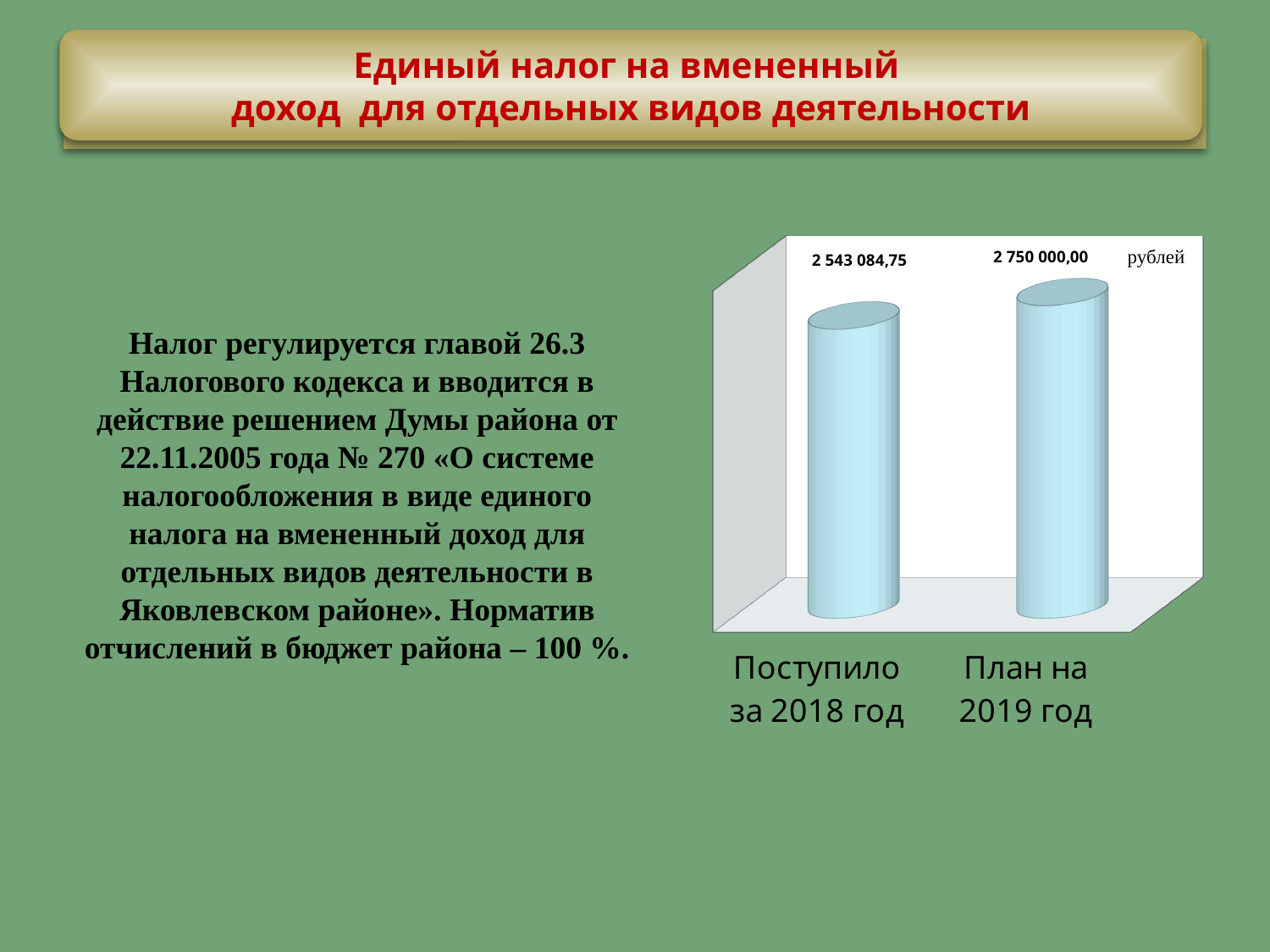
How many categories are plotted in the chart? 2 Which category has the highest value? План на 2019 год Which is larger: the value for "Поступило за 2018 год" or the value for "План на 2019 год"? План на 2019 год What colour are the bars in the chart? light blue What is the difference between the value for "План на 2019 год" and the value for "Поступило за 2018 год"? 206 915,25 What value is shown for "План на 2019 год"? 2 750 000,00 What value is shown for "Поступило за 2018 год"? 2 543 084,75 What kind of chart is shown on the slide? bar chart Which category has the lowest value? Поступило за 2018 год Do the values rise or fall from "Поступило за 2018 год" to "План на 2019 год"? rise What unit is indicated in the top right corner of the chart? рублей